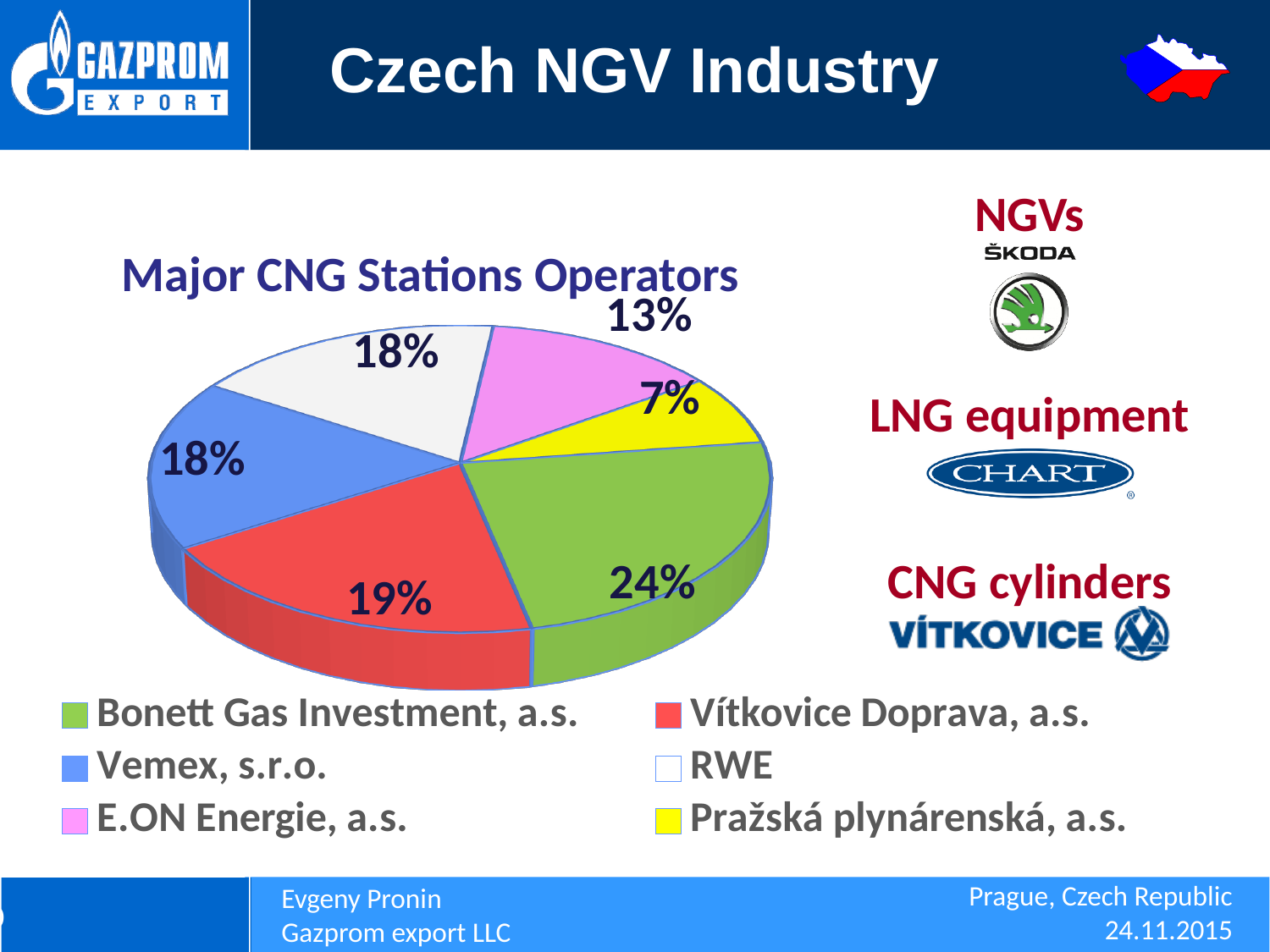
What is the difference in percentage points between Bonett Gas Investment, a.s. and Vítkovice Doprava, a.s.? 5 percentage points What type of chart is shown on the slide? pie chart How many operators are shown in the pie chart? 6 What share of the pie does Vítkovice Doprava, a.s. hold? 19% What is the title of the chart? Major CNG Stations Operators What share of the pie does E.ON Energie, a.s. hold? 13% Which has a larger share, E.ON Energie, a.s. or Vemex, s.r.o.? Vemex, s.r.o. What share of the pie does RWE hold? 18% Which operator has the largest share of the pie? Bonett Gas Investment, a.s. Which operator has the smallest share of the pie? Pražská plynárenská, a.s.